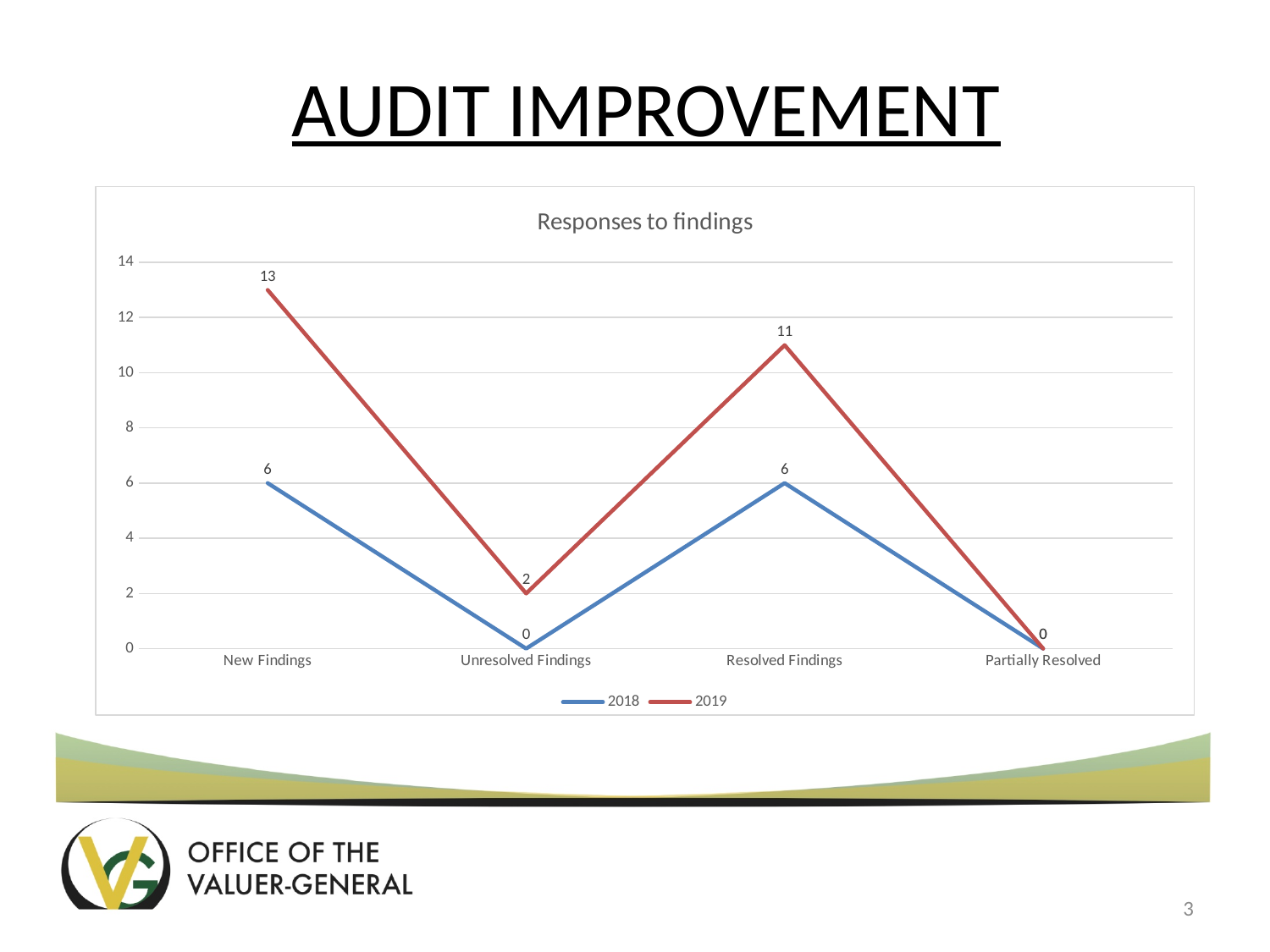
How many series does the legend list? 2 Which is larger for Resolved Findings, the 2018 value or the 2019 value? 2019 How many categories are shown on the x axis? 4 What is the 2019 value for Unresolved Findings? 2 What is the 2019 value for New Findings? 13 What is the 2018 value for Partially Resolved? 0 What is the title of the chart? Responses to findings What is the 2018 value for Resolved Findings? 6 What kind of chart is shown? Line chart Which category has the lowest 2019 value? Partially Resolved Which category has the highest 2019 value? New Findings What is the difference between the 2019 and 2018 values for New Findings? 7